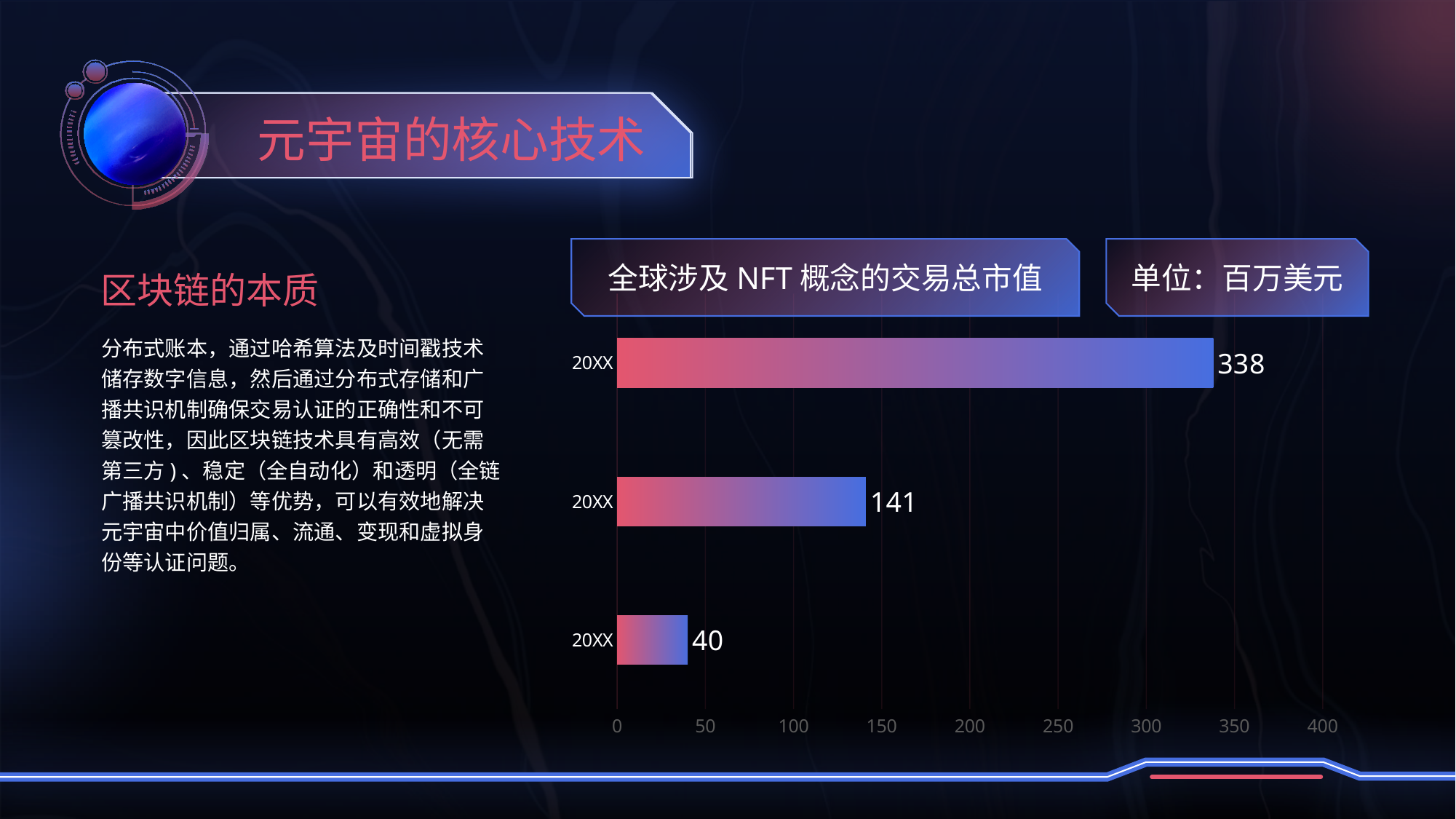
What is the value of the middle bar in the chart? 141 What is the title of the chart? 全球涉及 NFT 概念的交易总市值 What is the lowest value shown in the chart? 40 What is the difference between the middle bar and the bottom bar? 101 What kind of chart is shown on the slide? bar chart What is the value of the top bar in the chart? 338 Which is larger, the middle bar or the bottom bar? the middle bar How many bars are plotted in the chart? 3 What unit is stated for the chart values? 百万美元 What is the difference between the top bar and the middle bar? 197 What is the value of the bottom bar in the chart? 40 What is the highest value shown in the chart? 338